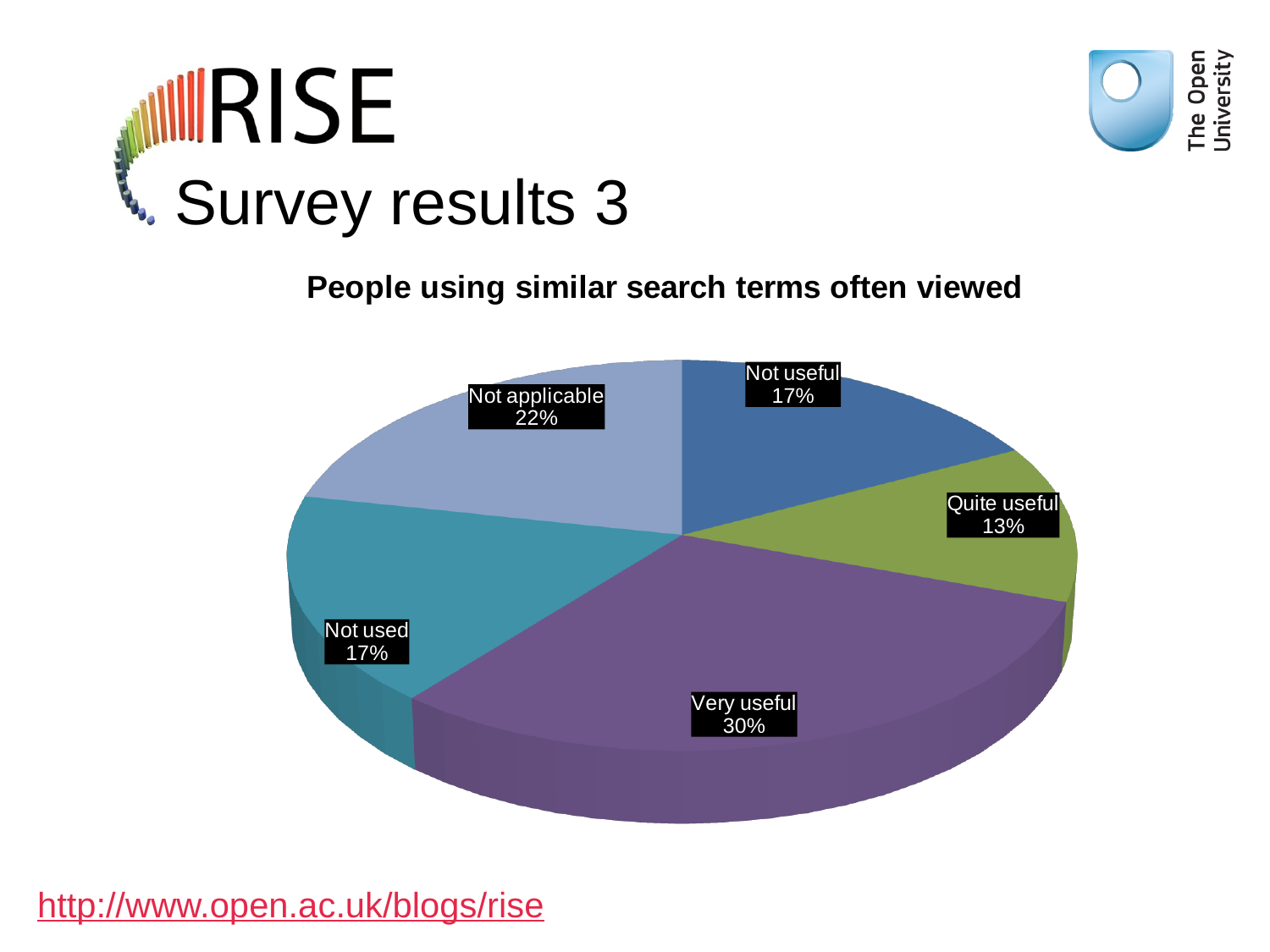
What is the combined share of the "Very useful" and "Quite useful" slices? 43% What is the difference in percentage points between the "Very useful" and "Quite useful" slices? 17 Which slice of the pie is the smallest? Quite useful What kind of chart is shown on the slide? Pie chart What share of the pie is labelled "Very useful"? 30% What share of the pie is labelled "Not applicable"? 22% What share of the pie is labelled "Not used"? 17% Which is larger, the "Not applicable" slice or the "Not useful" slice? Not applicable How many slices does the pie chart have? 5 Which slice of the pie is the largest? Very useful What is the title of the chart? People using similar search terms often viewed